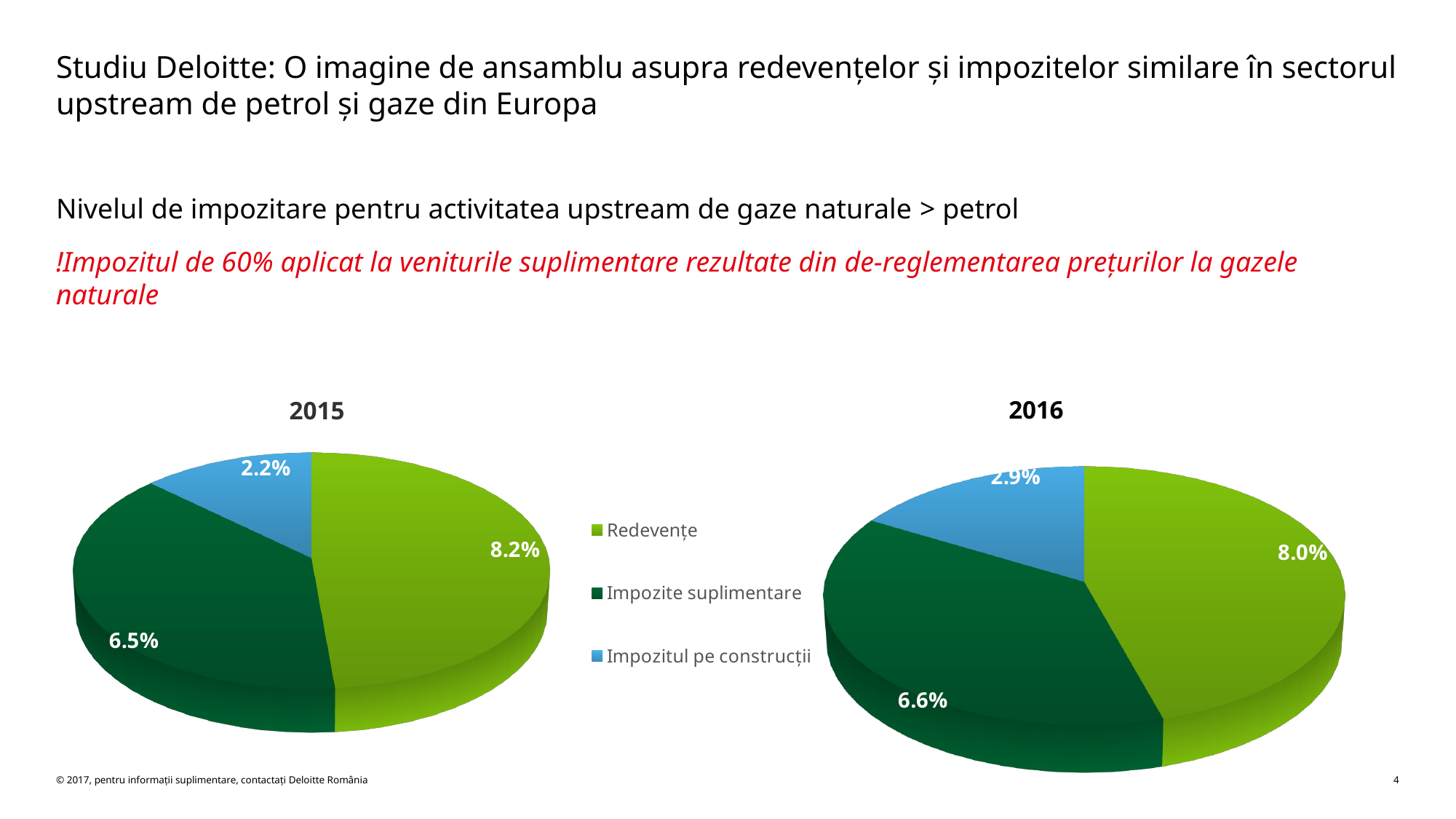
What type of chart is used for the 2015 and 2016 data? Pie chart In the 2016 pie chart, what is the value for Impozite suplimentare? 6.6% Which is larger: Impozitul pe construcții in the 2015 chart or in the 2016 chart? 2016 In the 2015 pie chart, what is the value for Impozitul pe construcții? 2.2% How many entries does the legend list? 3 In the 2015 pie chart, what is the difference between the values for Redevențe and Impozite suplimentare? 1.7% In the 2015 pie chart, which category has the largest value? Redevențe In the 2016 pie chart, what is the value for Redevențe? 8.0% In the 2016 pie chart, what is the value for Impozitul pe construcții? 2.9% In the 2016 pie chart, which category has the smallest value? Impozitul pe construcții In the 2015 pie chart, what is the value for Impozite suplimentare? 6.5% In the 2015 pie chart, what is the value for Redevențe? 8.2%